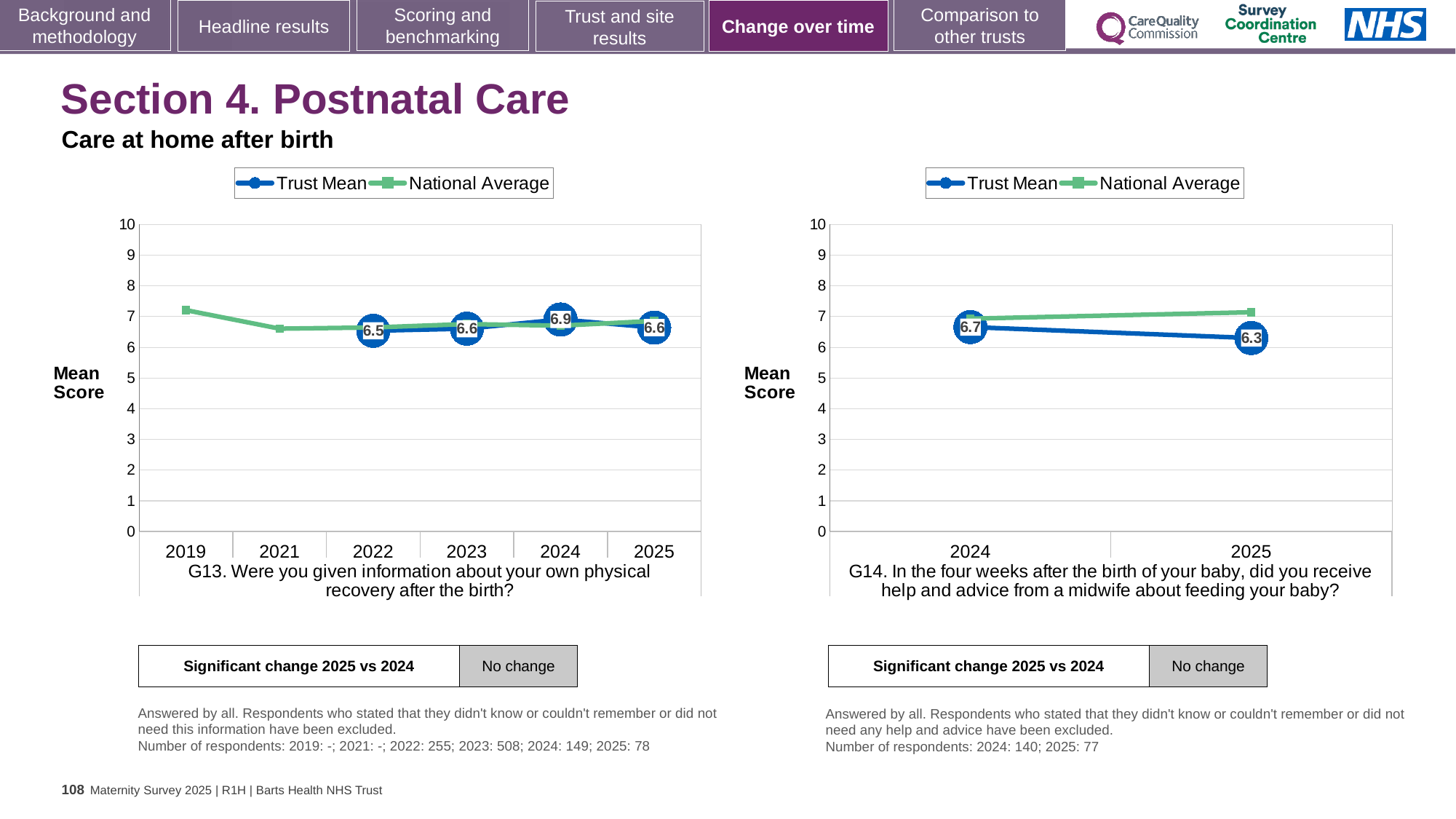
What kind of chart is the G14 chart on the right? Line chart In the G13 chart on the left, what is the Trust Mean for 2022? 6.5 In the G13 chart on the left, which year has the lowest Trust Mean? 2022 In the G14 chart on the right, does the Trust Mean rise or fall from 2024 to 2025? Fall In the G13 chart on the left, which year has the highest Trust Mean? 2024 In the G13 chart on the left, what is the Trust Mean for 2024? 6.9 In the G14 chart on the right, what is the difference between the Trust Mean for 2024 and 2025? 0.4 How many series does the legend of the G14 chart on the right list? 2 How many years are shown on the x axis of the G13 chart on the left? 6 In the G13 chart on the left, is the Trust Mean higher in 2024 or 2025? 2024 In the G14 chart on the right, what is the Trust Mean for 2025? 6.3 In the G13 chart on the left, is the National Average for 2019 greater or less than 7? greater